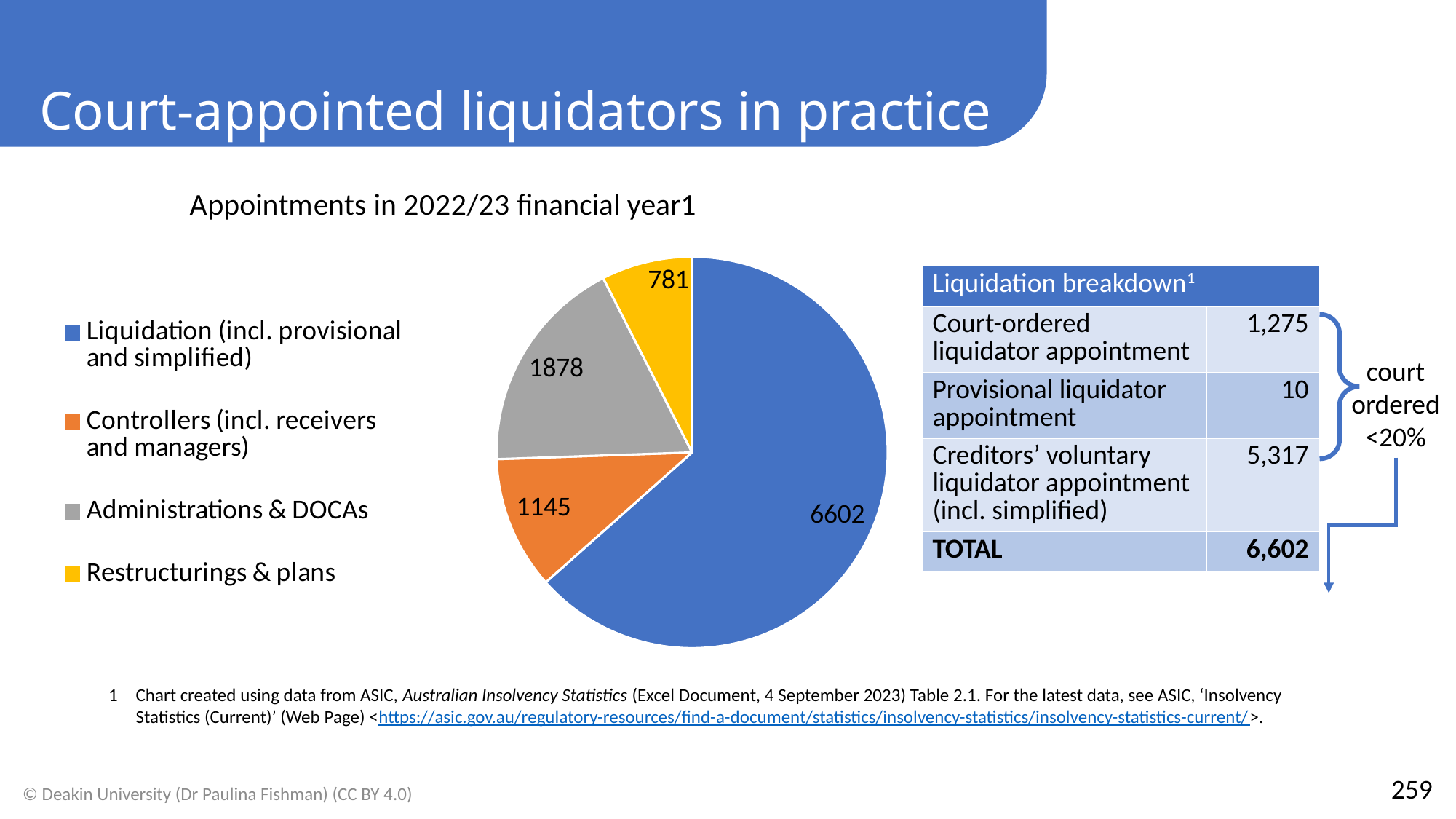
Which is larger in the pie chart: Administrations & DOCAs or Controllers (incl. receivers and managers)? Administrations & DOCAs What is the value for Restructurings & plans in the pie chart? 781 What is the value for Controllers (incl. receivers and managers) in the pie chart? 1145 Which category has the largest slice in the pie chart? Liquidation (incl. provisional and simplified) What is the difference between the Liquidation value and the Controllers value in the pie chart? 5457 What is the value for Liquidation (incl. provisional and simplified) in the pie chart? 6602 What is the difference between the Administrations & DOCAs value and the Restructurings & plans value? 1097 What is the value for Administrations & DOCAs in the pie chart? 1878 How many categories does the pie chart show? 4 What is the title of the pie chart? Appointments in 2022/23 financial year1 What kind of chart is shown on the slide? Pie chart Which category has the smallest slice in the pie chart? Restructurings & plans